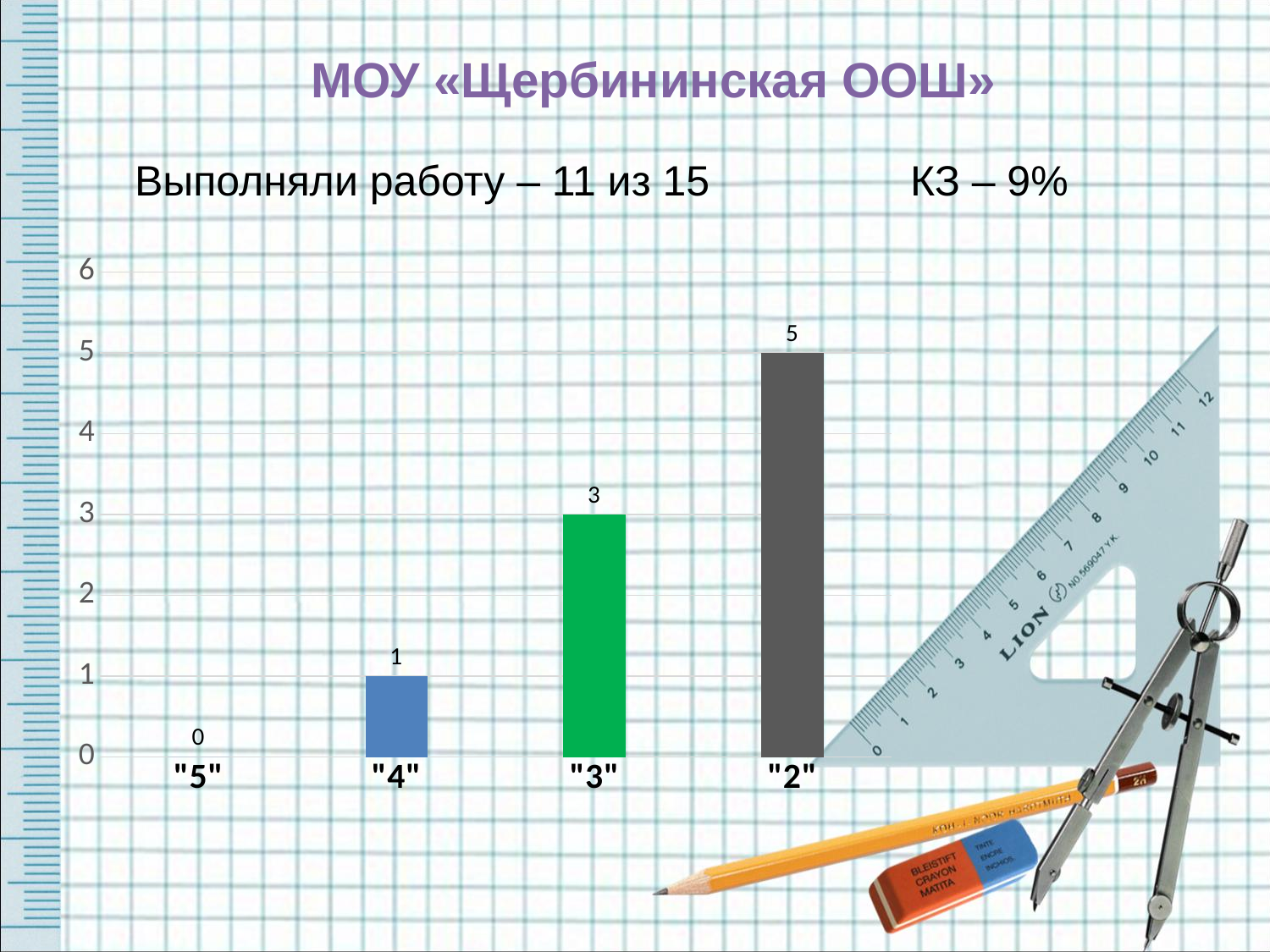
Which category has the lowest value? "5" What is the difference between the values for "2" and "3"? 2 What value is shown for the category "4"? 1 What kind of chart is shown on the slide? bar chart How many categories are shown on the x axis? 4 What colour is the bar for the category "3"? green What value is shown for the category "3"? 3 What value is shown for the category "5"? 0 What value is shown for the category "2"? 5 Do the values rise or fall from left to right along the x axis? rise Which category has the highest value? "2" Which is larger, the value for "3" or the value for "4"? "3"